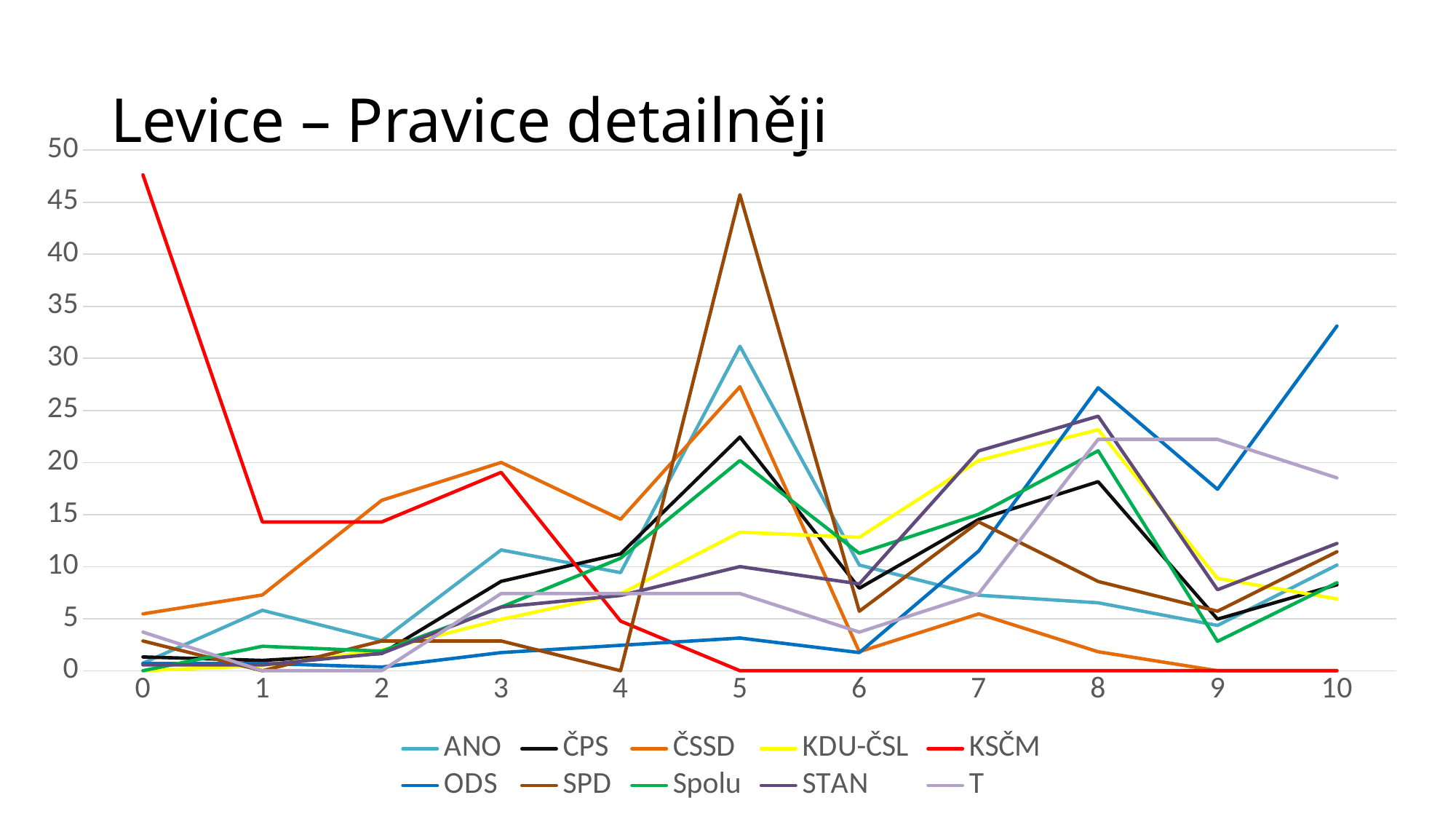
What is the title of the chart? Levice – Pravice detailněji At x = 5, which is larger, the value for SPD or the value for ANO? SPD How many points are there along the x axis? 11 Does the KSČM line rise or fall from x = 0 to x = 5? fall Which series has the highest value at x = 10? ODS How many series does the legend list? 10 Which series has the highest value at x = 0? KSČM Is the value for SPD at x = 5 greater or less than 40? greater What kind of chart is shown on the slide? line chart Is the value for ANO at x = 5 greater or less than 30? greater Which series has the highest value at x = 5? SPD Is the value for KSČM at x = 0 greater or less than 45? greater